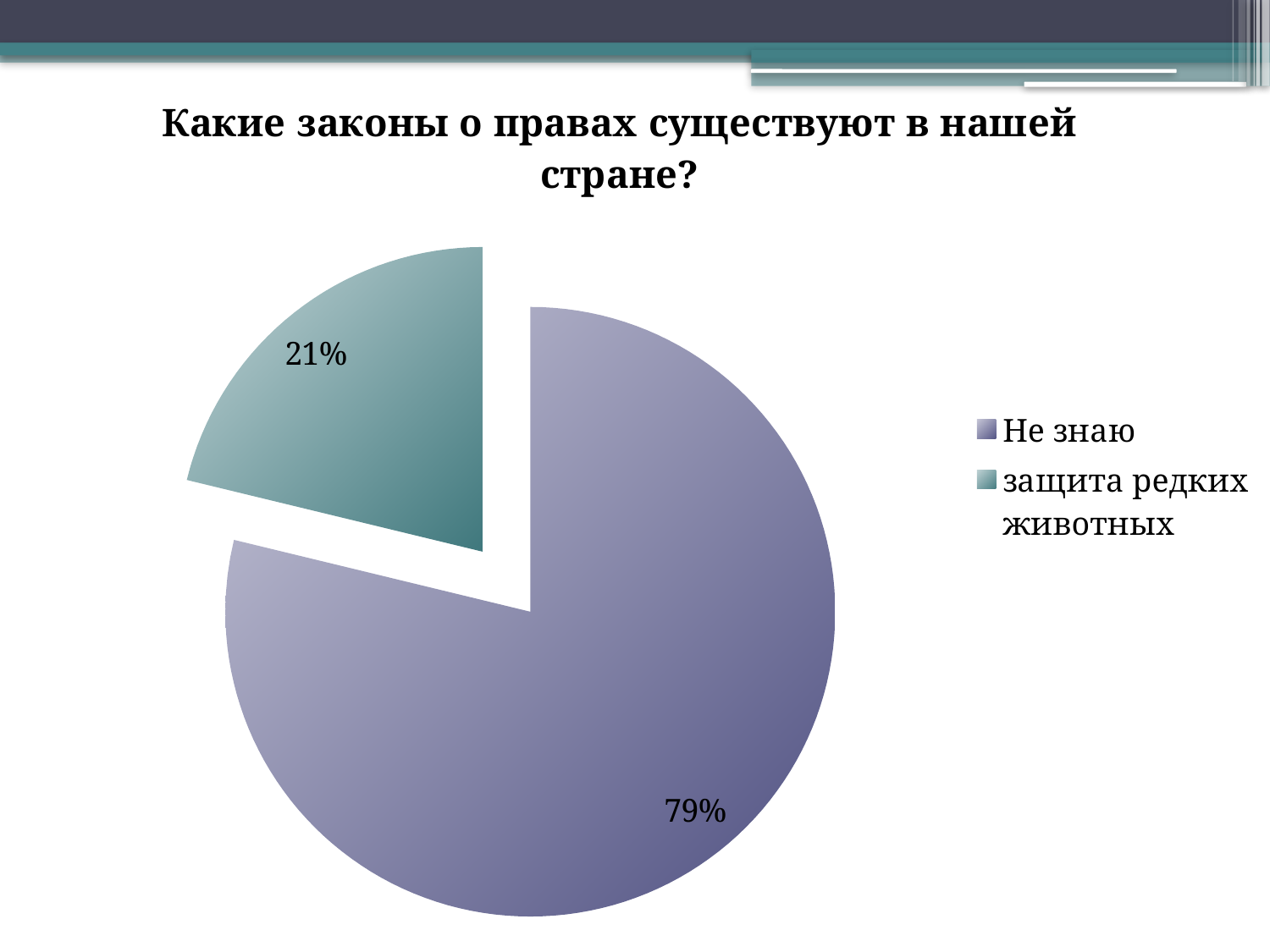
How many slices does the pie chart have? 2 How many entries does the legend list? 2 Which is larger: the slice for "Не знаю" or the slice for "защита редких животных"? Не знаю What share of the pie does "Не знаю" have? 79% Which category has the smallest slice of the pie? защита редких животных Which slice is pulled out (exploded) from the pie? защита редких животных What is the difference in percentage points between the "Не знаю" slice and the "защита редких животных" slice? 58 Which category has the largest slice of the pie? Не знаю What kind of chart is shown on the slide? pie chart What share of the pie does "защита редких животных" have? 21% What is the title of the chart? Какие законы о правах существуют в нашей стране?